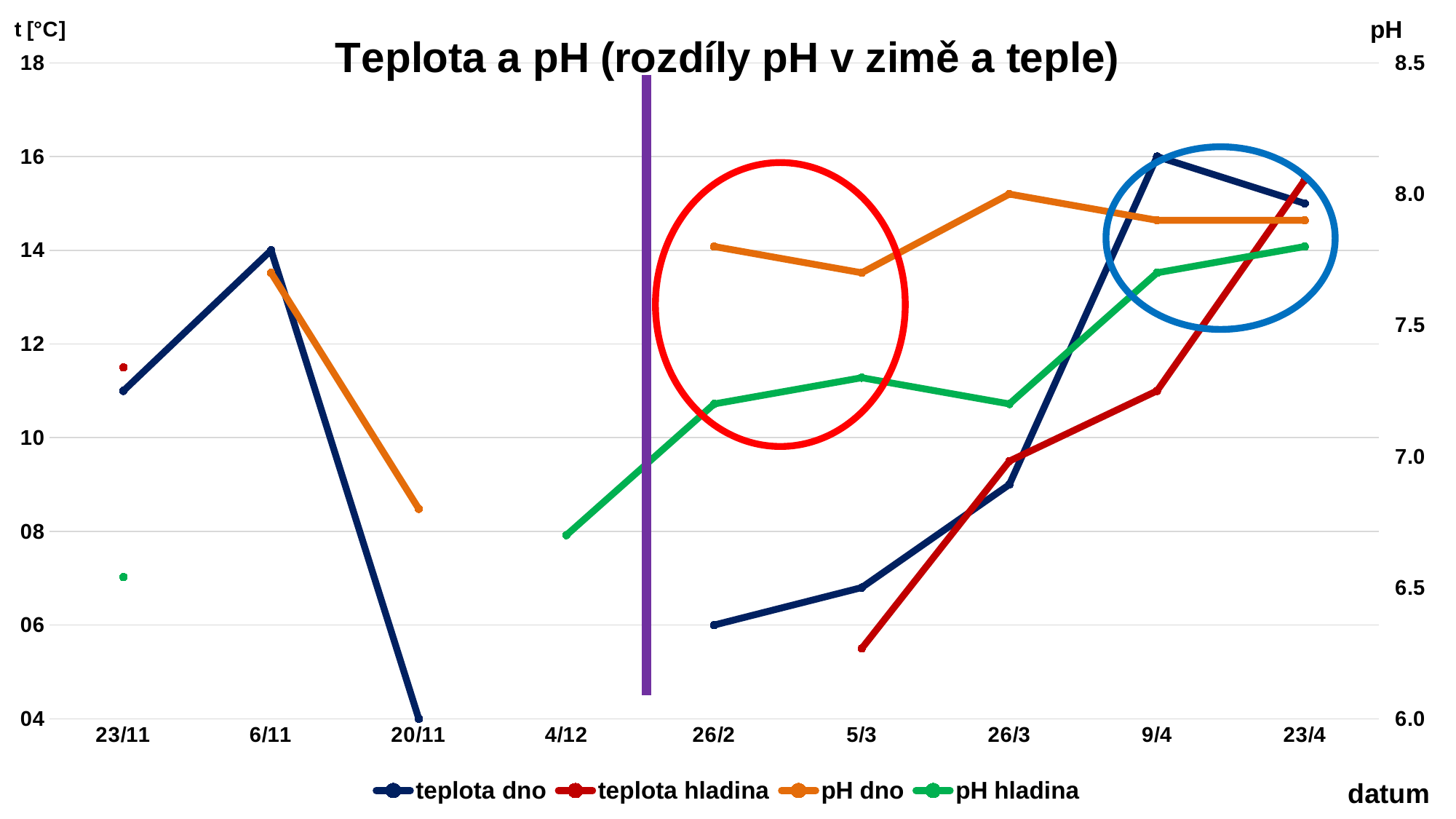
Is the value for 'pH dno' on 26/3 greater or less than 7.5? greater How many series does the legend list? 4 On which date does the 'teplota dno' series reach its lowest value? 20/11 On 9/4, which series has the higher temperature, 'teplota dno' or 'teplota hladina'? teplota dno On which date does the 'teplota dno' series reach its highest value? 9/4 How many dates are shown on the x axis? 9 What kind of chart is shown on the slide? line chart What is the label of the right-hand vertical axis? pH Is the value for 'teplota hladina' on 5/3 greater or less than 06 °C? less What is the title of the chart? Teplota a pH (rozdíly pH v zimě a teple) Does the 'teplota dno' series rise or fall from 26/2 to 9/4? rise Is the value for 'pH hladina' on 4/12 greater or less than 7.0? less